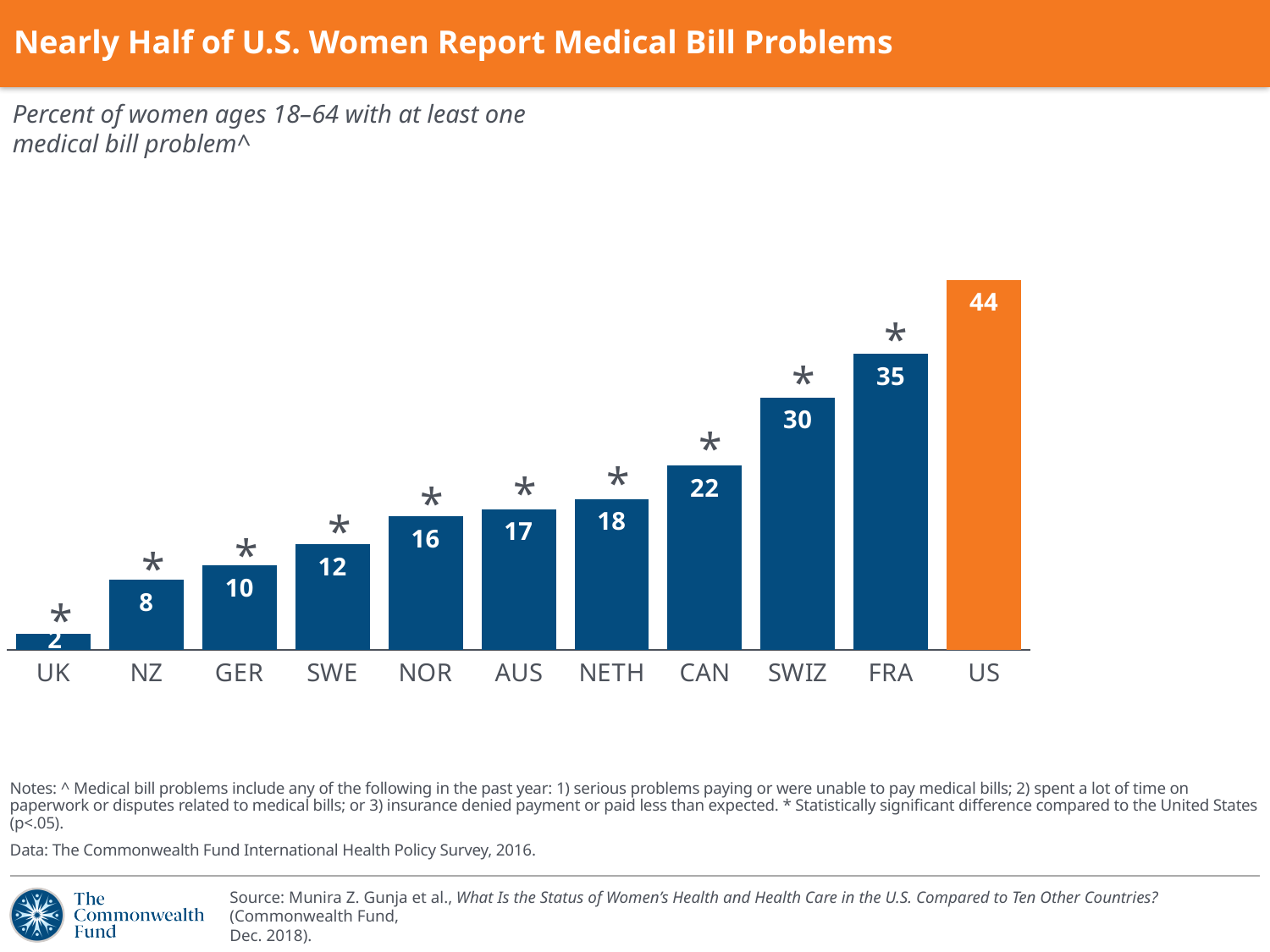
Which is larger, the value for NOR or the value for NETH? NETH Which country has the lowest value? UK What is the value for the US? 44 What kind of chart is this? Bar chart What is the difference between the values for the US and FRA? 9 What is the value for SWE? 12 How many countries are shown on the chart? 11 What is the value for CAN? 22 Do the values rise or fall from left to right along the x axis? Rise Which country has the highest value? US What is the value for FRA? 35 What is the difference between the values for SWIZ and NZ? 22